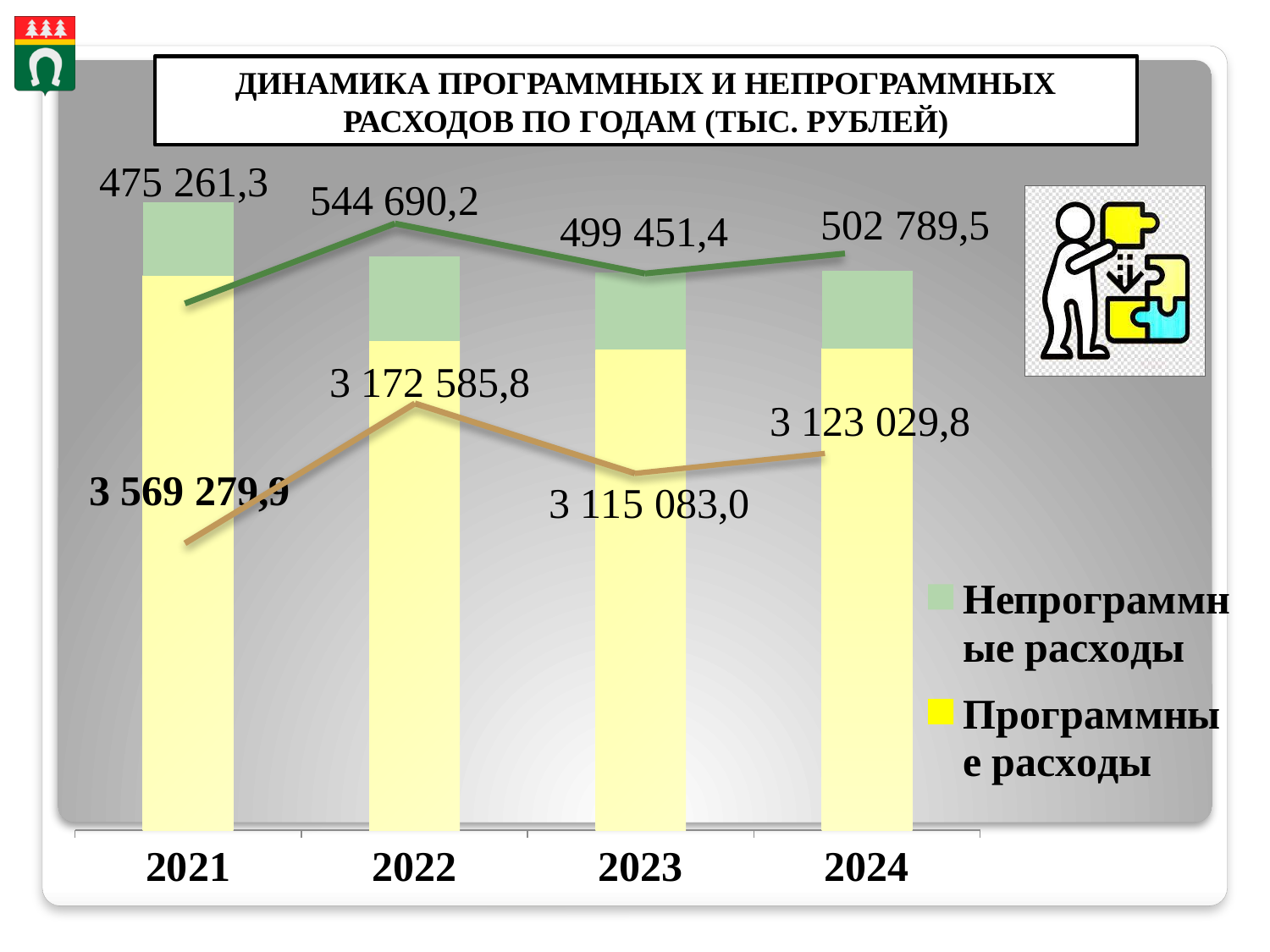
What is the difference between Непрограммные расходы in 2022 and in 2021? 69 428,9 What is the value of Непрограммные расходы for 2022? 544 690,2 How many years are shown on the x axis? 4 What is the value of Программные расходы for 2022? 3 172 585,8 What is the total of the stacked bar for 2023? 3 614 534,4 How many series does the legend list? 2 What is the value of Программные расходы for 2023? 3 115 083,0 What is the value of Непрограммные расходы for 2024? 502 789,5 In which year are Непрограммные расходы the lowest? 2021 Which year has larger Непрограммные расходы, 2023 or 2024? 2024 In which year are Непрограммные расходы the highest? 2022 In which year are Программные расходы the highest? 2021